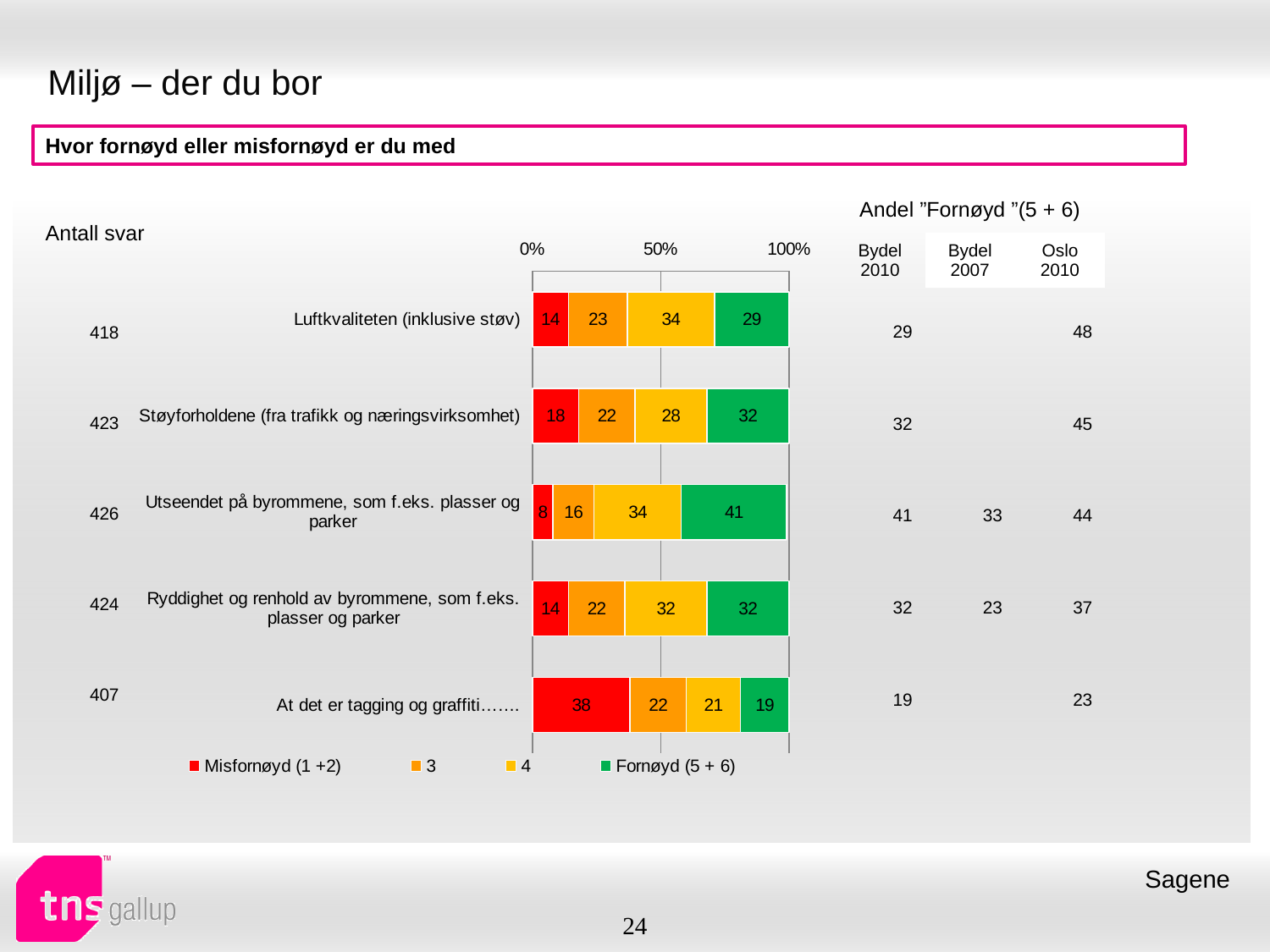
What is the value of the "4" segment for "Støyforholdene (fra trafikk og næringsvirksomhet)"? 28 Which colour represents "Fornøyd (5 + 6)" in the chart? Green What is the value of "Misfornøyd (1 +2)" for "At det er tagging og graffiti…"? 38 How many series does the legend list? 4 What is the value of "Fornøyd (5 + 6)" for "Luftkvaliteten (inklusive støv)"? 29 What is the difference between the "Fornøyd (5 + 6)" values for "Utseendet på byrommene, som f.eks. plasser og parker" and "At det er tagging og graffiti…"? 22 How many categories are shown in the chart? 5 What kind of chart is shown on the slide? Stacked bar chart What is the total of the stacked bar for "Ryddighet og renhold av byrommene, som f.eks. plasser og parker"? 100 Which category has the lowest "Misfornøyd (1 +2)" value? Utseendet på byrommene, som f.eks. plasser og parker Which is larger: the "Misfornøyd (1 +2)" value for "Støyforholdene (fra trafikk og næringsvirksomhet)" or for "Luftkvaliteten (inklusive støv)"? Støyforholdene (fra trafikk og næringsvirksomhet) Which category has the highest "Fornøyd (5 + 6)" value? Utseendet på byrommene, som f.eks. plasser og parker